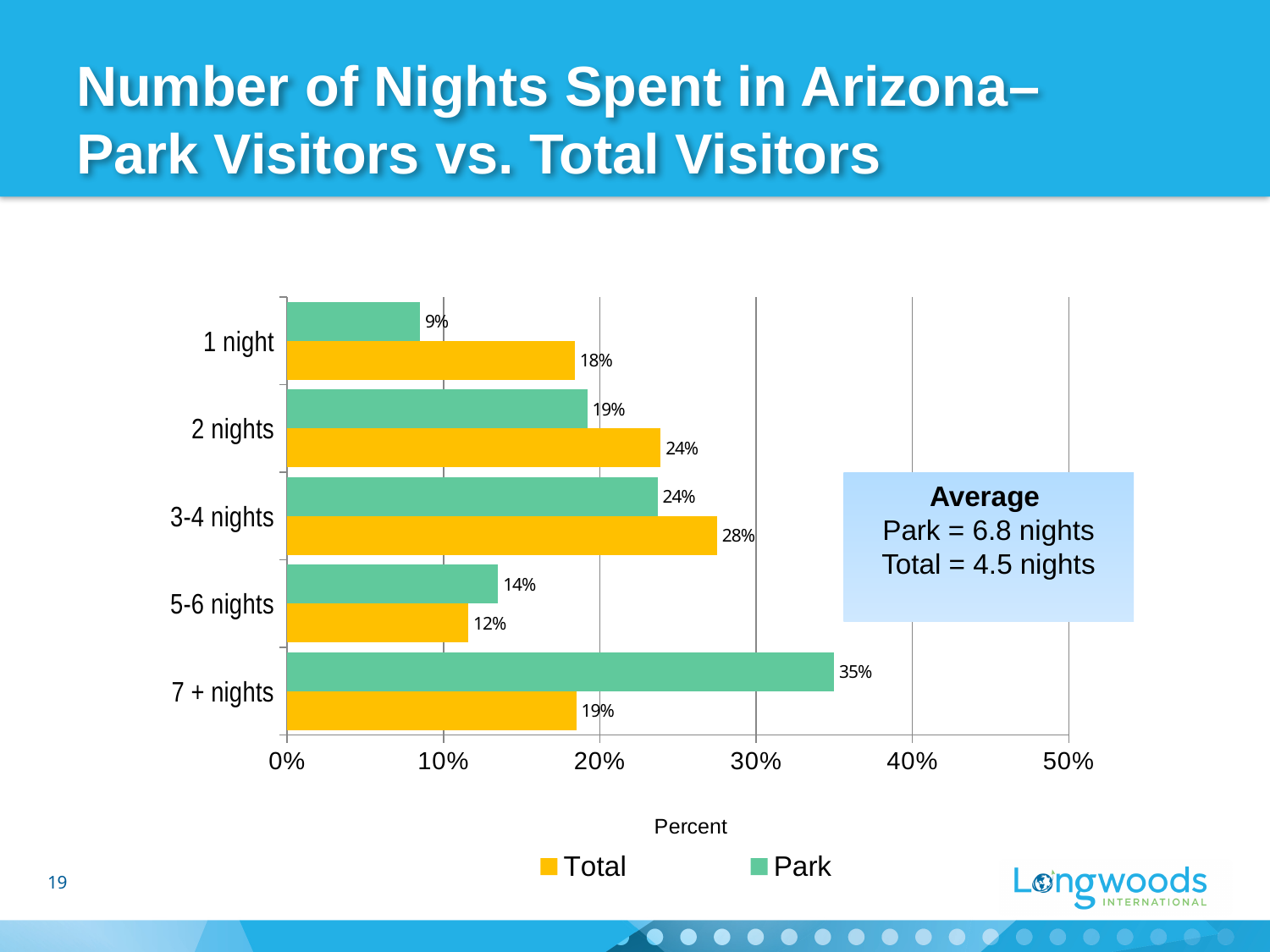
According to the text box on the chart, what is the average number of nights for Park visitors? 6.8 nights What is the difference between the Park and Total values for 7 + nights? 16% What is the value for Park visitors in the 5-6 nights category? 14% Is the Park value for 7 + nights greater or less than 30%? greater What kind of chart is shown on the slide? Bar chart How many series does the legend list? 2 For 3-4 nights, which series has the larger value, Total or Park? Total Which category has the lowest value for Total visitors? 5-6 nights How many night categories are shown on the chart? 5 What percentage of Total visitors spent 1 night in Arizona? 18% What percentage of Park visitors spent 7 + nights in Arizona? 35% Which category has the highest value for Park visitors? 7 + nights